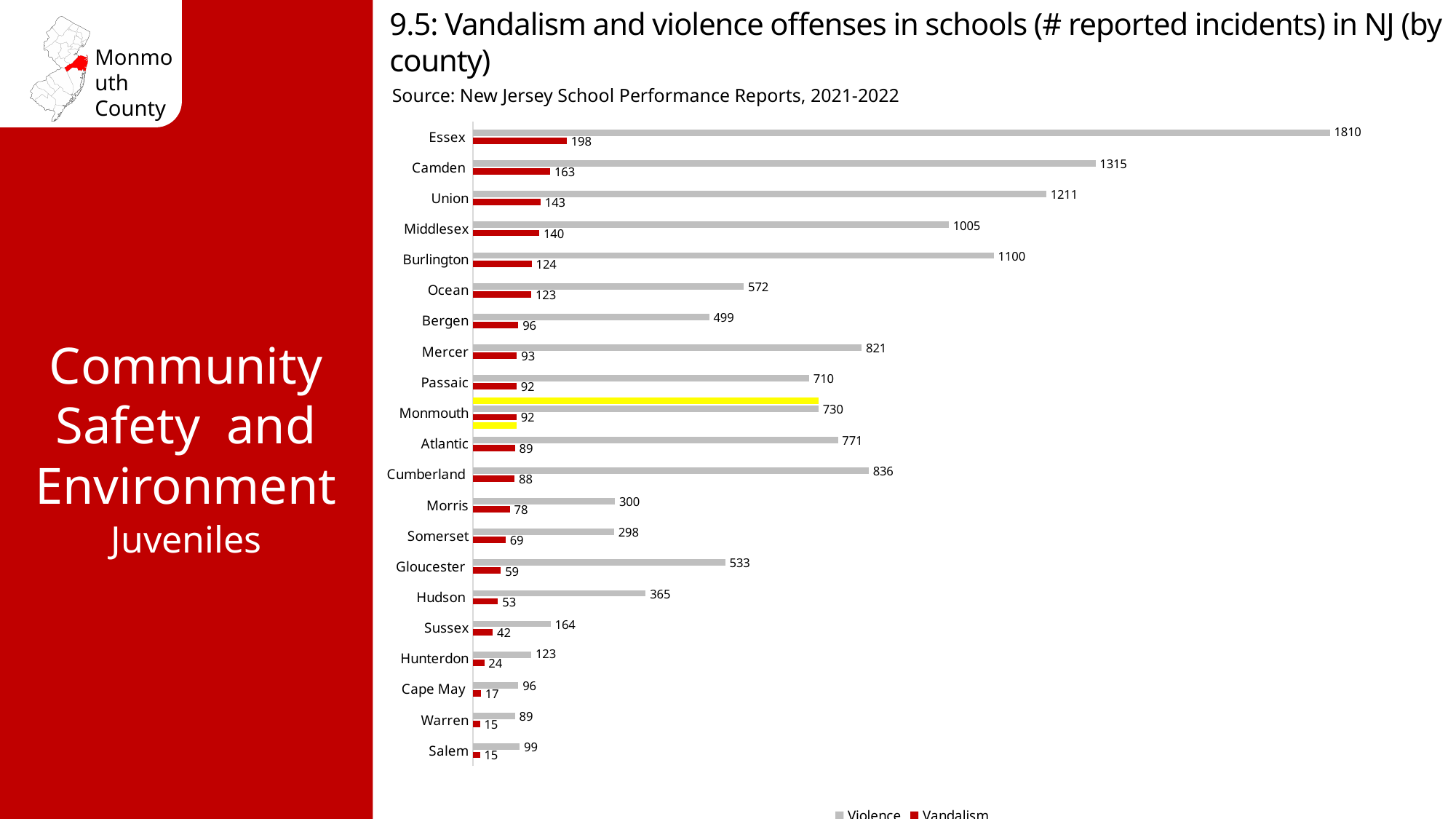
Which county has more violence incidents, Monmouth or Passaic? Monmouth Which series is shown in red in the chart? Vandalism Which county has the highest number of violence incidents? Essex How many series does the legend list? 2 What is the difference between the violence values for Camden and Union? 104 How many violence incidents are reported for Cumberland County? 836 What type of chart is shown on the slide? Bar chart Which county has the lowest number of violence incidents? Warren Which county has more vandalism incidents, Hudson or Gloucester? Gloucester How many reported violence incidents are shown for Essex County? 1810 How many counties are shown in the chart? 21 What is the vandalism value for Monmouth County? 92